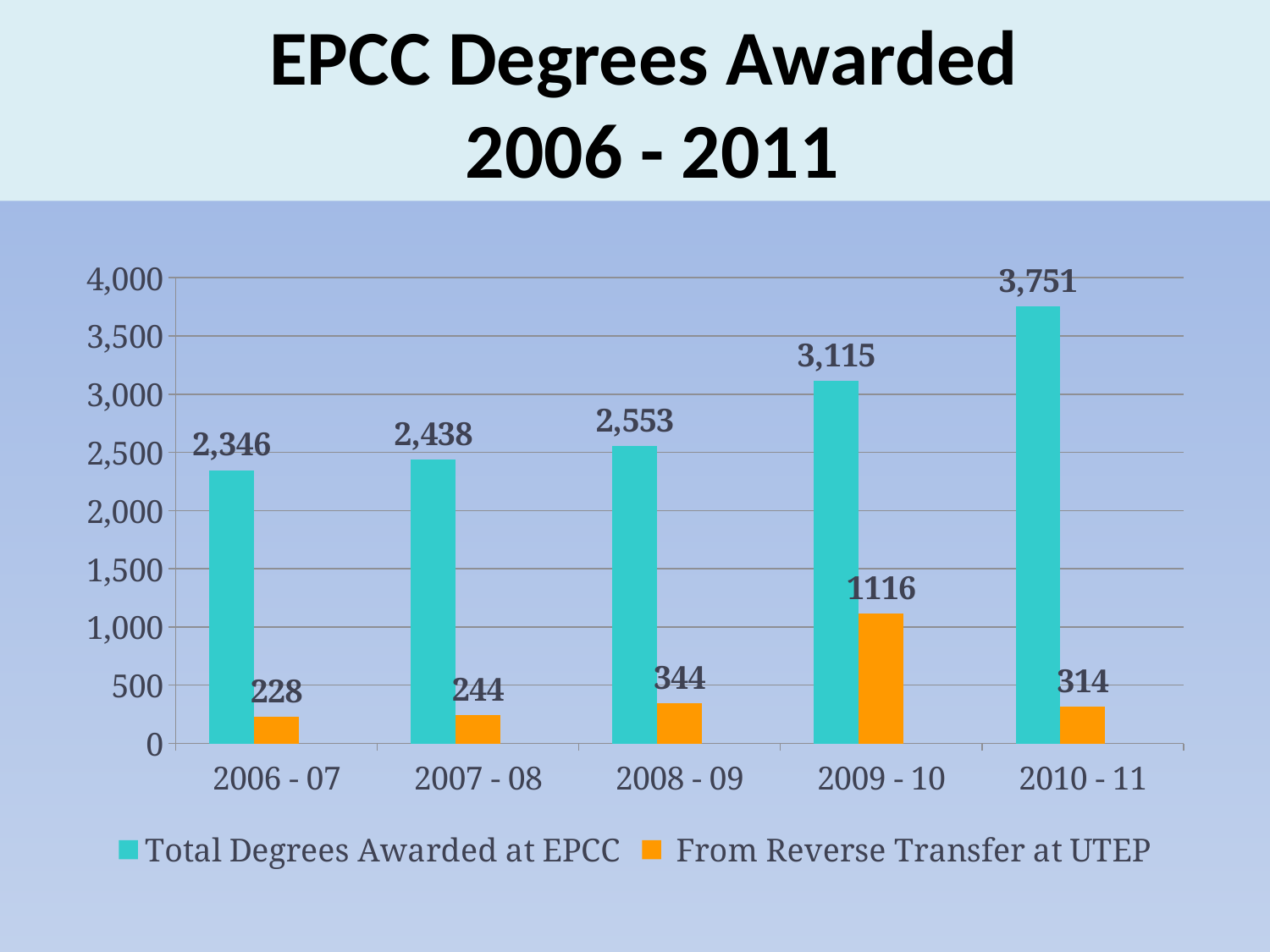
What is the value for From Reverse Transfer at UTEP in 2006 - 07? 228 Which year has the highest value for Total Degrees Awarded at EPCC? 2010 - 11 What is the difference between From Reverse Transfer at UTEP in 2008 - 09 and in 2010 - 11? 30 How many series does the legend list? 2 How many years are shown on the x axis? 5 What is the value for Total Degrees Awarded at EPCC in 2008 - 09? 2,553 What is the difference between Total Degrees Awarded at EPCC in 2010 - 11 and in 2009 - 10? 636 What is the value for From Reverse Transfer at UTEP in 2009 - 10? 1116 Do the values for Total Degrees Awarded at EPCC rise or fall from 2006 - 07 to 2010 - 11? Rise What kind of chart is shown on the slide? Bar chart Which year has the lowest value for From Reverse Transfer at UTEP? 2006 - 07 Which is larger: From Reverse Transfer at UTEP in 2007 - 08 or in 2010 - 11? 2010 - 11